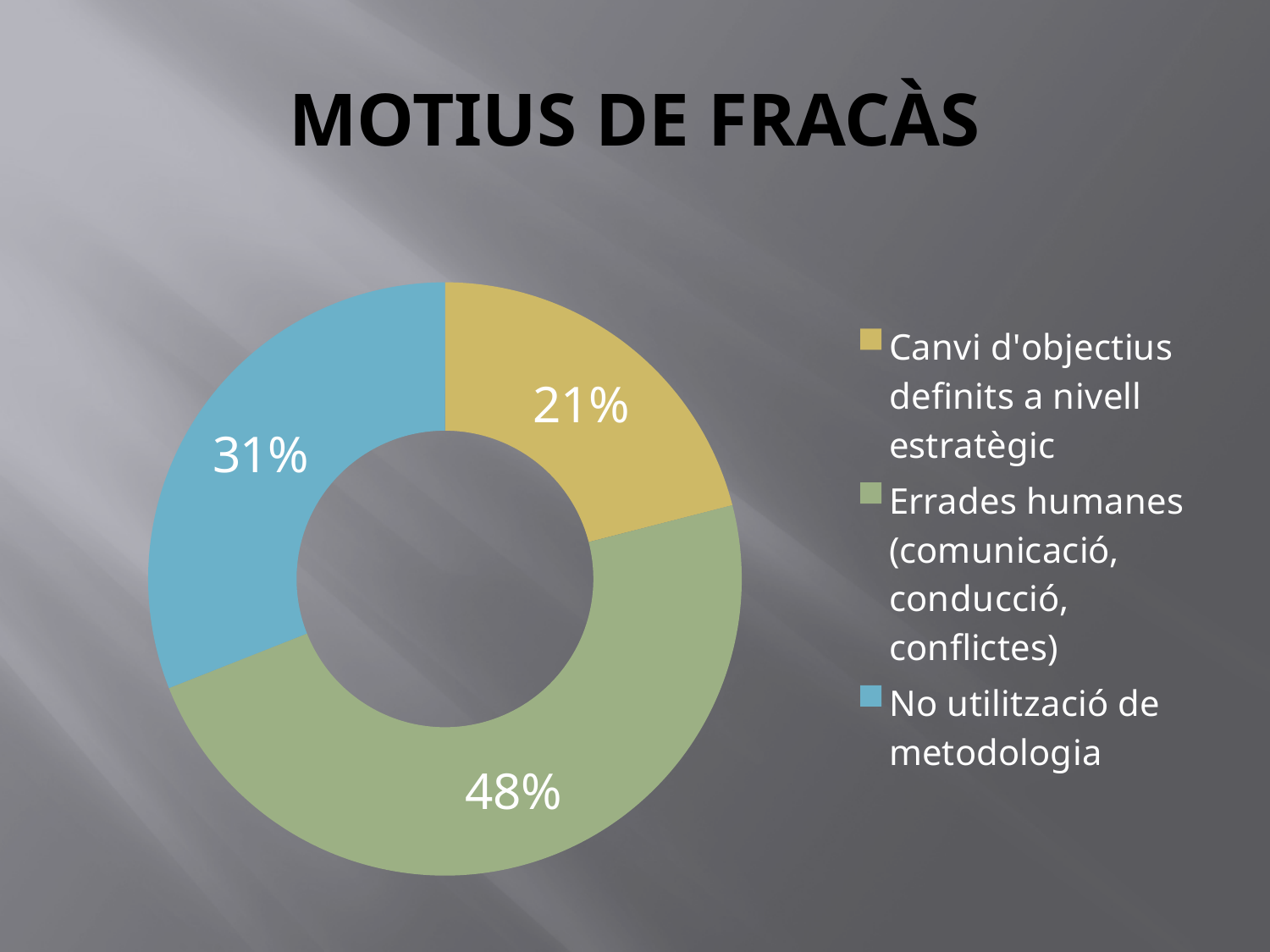
Which category has the smallest share of the chart? Canvi d'objectius definits a nivell estratègic What share of the chart does 'Errades humanes (comunicació, conducció, conflictes)' represent? 48% What is the difference between the shares for 'Errades humanes' and 'No utilització de metodologia'? 17% What is the value shown for 'Canvi d'objectius definits a nivell estratègic'? 21% How many categories does the chart show? 3 Which is larger: the share for 'No utilització de metodologia' or for 'Canvi d'objectius definits a nivell estratègic'? No utilització de metodologia What is the difference between the shares for 'No utilització de metodologia' and 'Canvi d'objectius definits a nivell estratègic'? 10% What is the title of the slide containing the chart? MOTIUS DE FRACÀS What colour represents 'No utilització de metodologia' in the chart? Blue What is the value shown for 'No utilització de metodologia'? 31% Which category has the largest share of the chart? Errades humanes (comunicació, conducció, conflictes) What kind of chart is shown on the slide? Doughnut (pie) chart